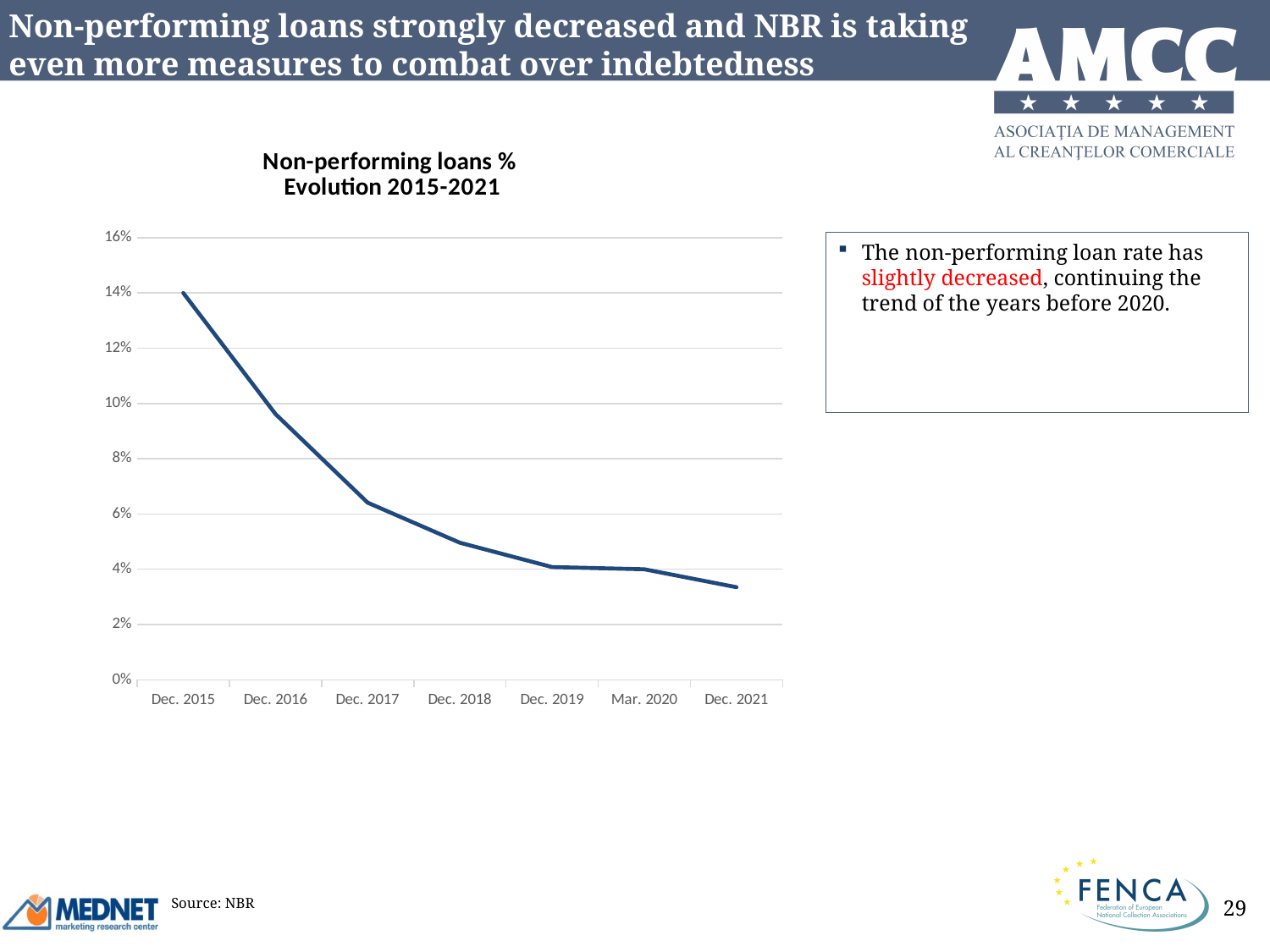
Which period has the highest non-performing loans percentage? Dec. 2015 What is the title of the chart? Non-performing loans % Evolution 2015-2021 Which period has the lowest non-performing loans percentage? Dec. 2021 Which is larger, the value for Dec. 2016 or the value for Dec. 2018? Dec. 2016 What is the source cited for the chart data? NBR What kind of chart is shown on the slide? line chart Is the value for Dec. 2017 greater or less than 8%? less Is the value for Dec. 2016 greater or less than 8%? greater Do the non-performing loan values rise or fall from Dec. 2015 to Dec. 2021? fall Is the value for Dec. 2018 greater or less than 4%? greater How many data points are plotted on the line chart? 7